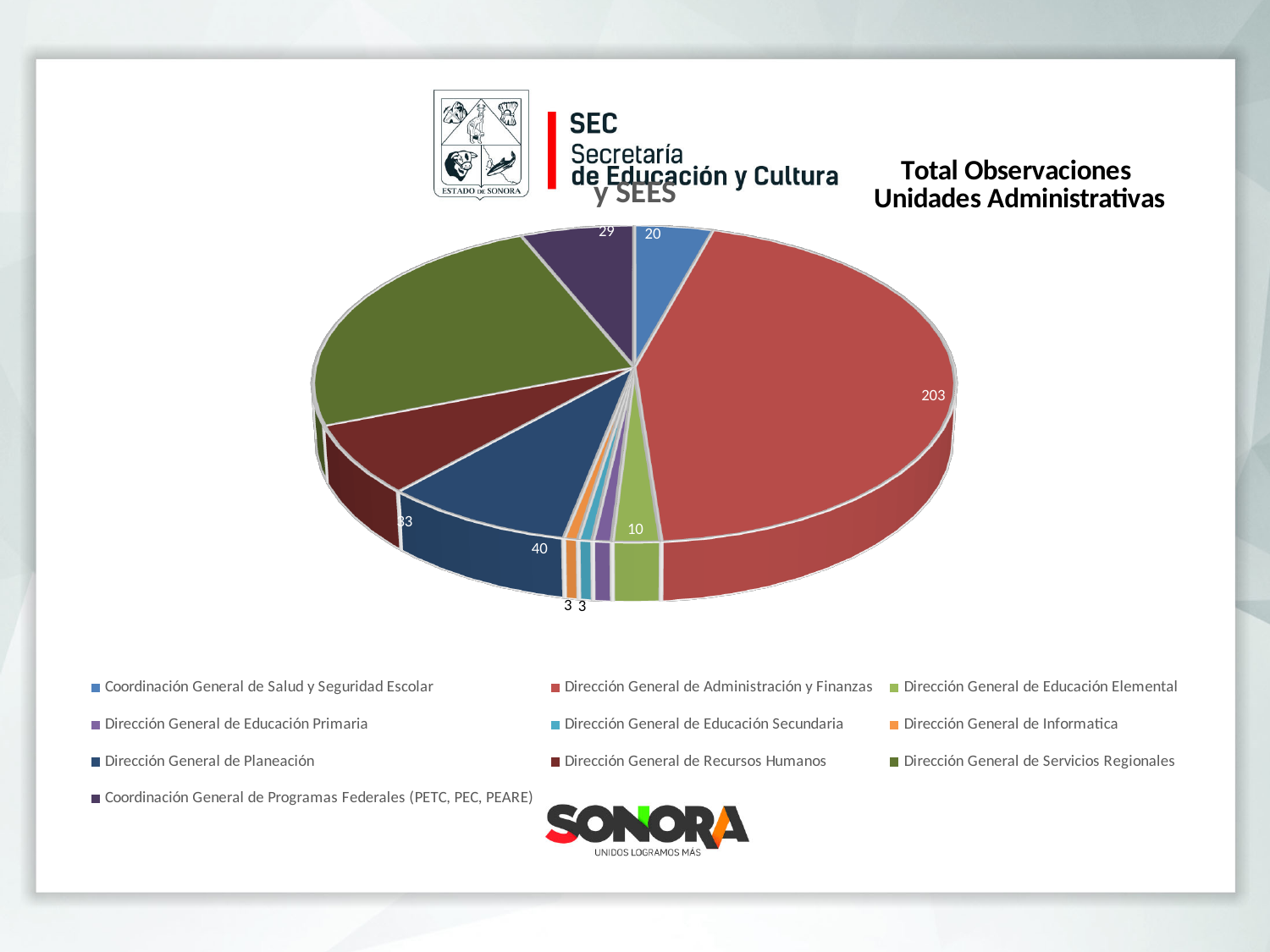
What is the difference between the values for Dirección General de Administración y Finanzas and Dirección General de Planeación? 163 Which is larger: the value for Dirección General de Planeación or for Coordinación General de Salud y Seguridad Escolar? Dirección General de Planeación What is the value for Coordinación General de Salud y Seguridad Escolar? 20 What is the value for Dirección General de Educación Elemental? 10 What kind of chart is shown on the slide? Pie chart How many administrative units are listed in the legend? 10 What is the difference between the values for Coordinación General de Programas Federales (PETC, PEC, PEARE) and Coordinación General de Salud y Seguridad Escolar? 9 Which unit has the largest slice of the pie? Dirección General de Administración y Finanzas What is the value for Dirección General de Planeación? 40 What is the title of the chart? Total Observaciones Unidades Administrativas What is the value for Dirección General de Administración y Finanzas? 203 What is the value for Coordinación General de Programas Federales (PETC, PEC, PEARE)? 29